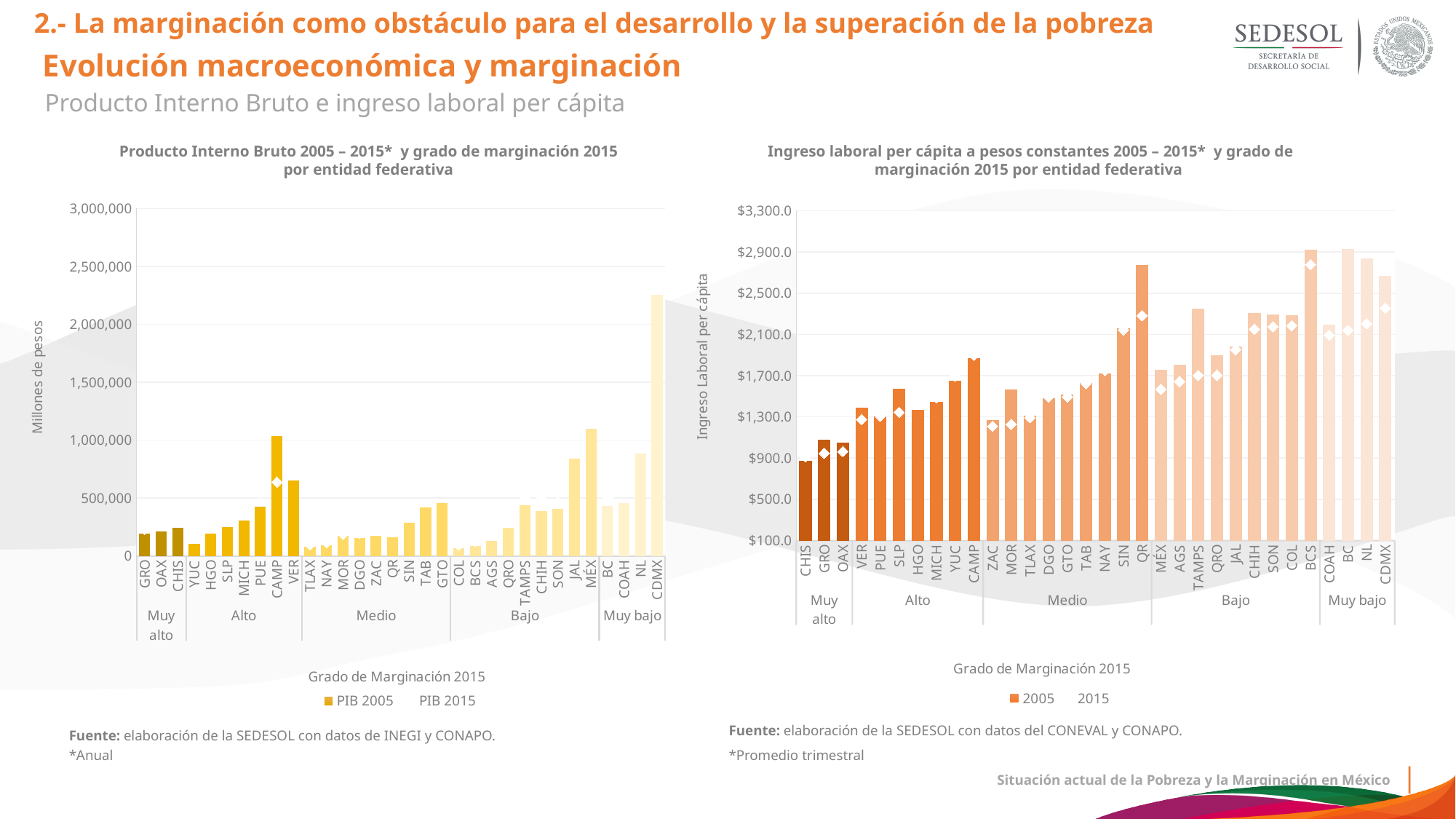
On the right chart (Ingreso laboral per cápita), is the 2015 value for CAMP greater or less than $1,700.0? greater On the left chart (Producto Interno Bruto 2005 – 2015), what is the label of the vertical axis? Millones de pesos On the left chart (Producto Interno Bruto 2005 – 2015), is the PIB 2015 value for CDMX greater or less than 2,000,000? greater On the left chart (Producto Interno Bruto 2005 – 2015), which entity has the highest PIB 2015 bar? CDMX What kind of chart is the right chart (Ingreso laboral per cápita)? bar chart On the right chart (Ingreso laboral per cápita), is the 2015 value for QR greater or less than $2,500.0? less On the right chart (Ingreso laboral per cápita), how many entities are shown on the x axis? 32 On the right chart (Ingreso laboral per cápita), which entity has the lowest 2015 bar? CHIS On the left chart (Producto Interno Bruto 2005 – 2015), how many series does the legend list? 2 On the right chart (Ingreso laboral per cápita), which has the larger 2015 bar, QR or MÉX? QR